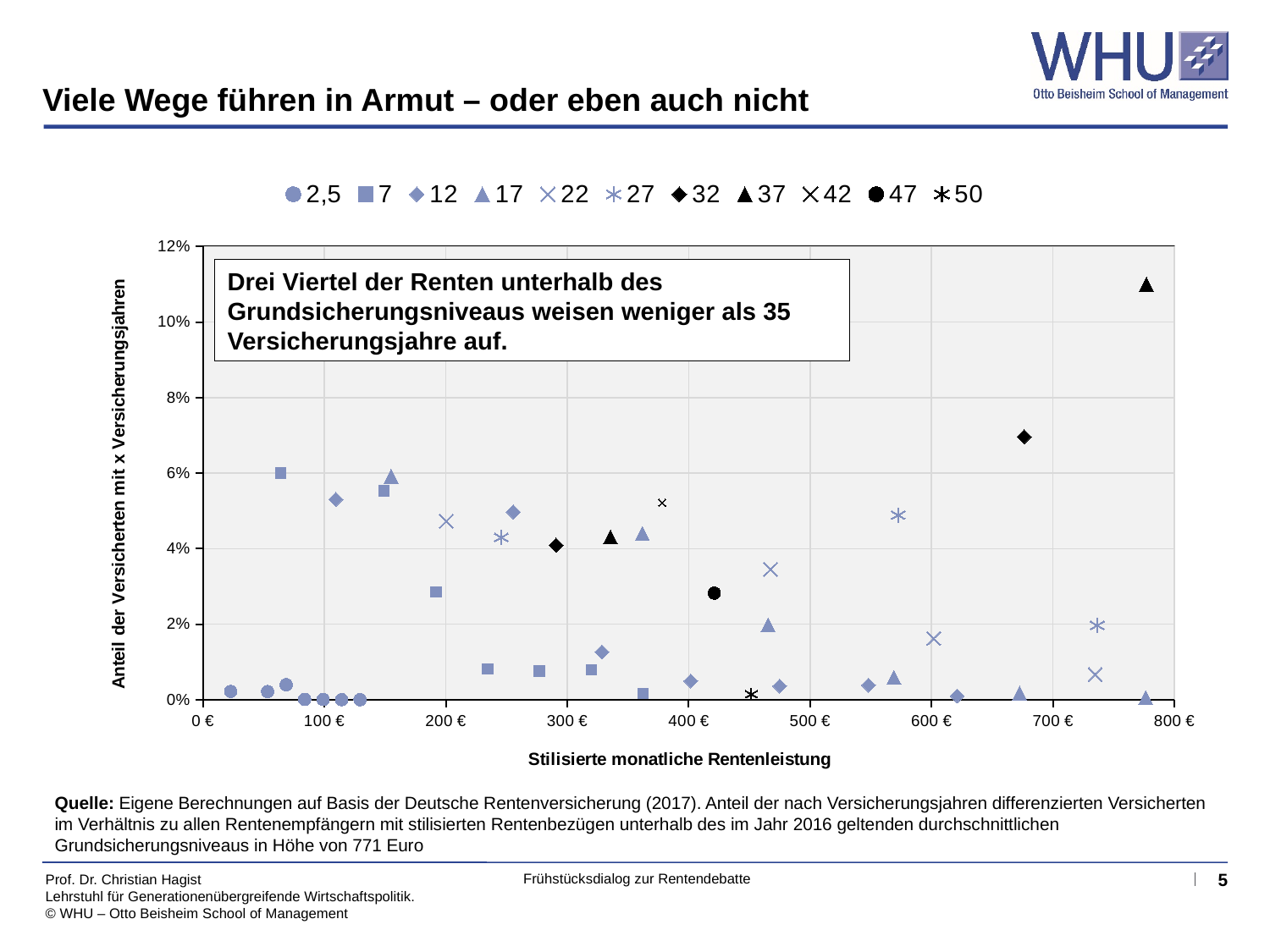
Is the value of the 50 series point (around 450 €) greater or less than 2%? less Is the highest point of the 37 series greater or less than 10%? greater Which series has the highest plotted point on the chart? 37 What kind of chart is shown on the slide? scatter chart Which is larger: the 37 series point near 775 € or the 32 series point near 675 €? the 37 series point Is the value of the 47 series point (around 420 €) greater or less than 4%? less What is the maximum value shown on the x axis? 800 € How many series does the legend list? 11 What is the title of the x axis? Stilisierte monatliche Rentenleistung What is the title of the y axis? Anteil der Versicherten mit x Versicherungsjahren